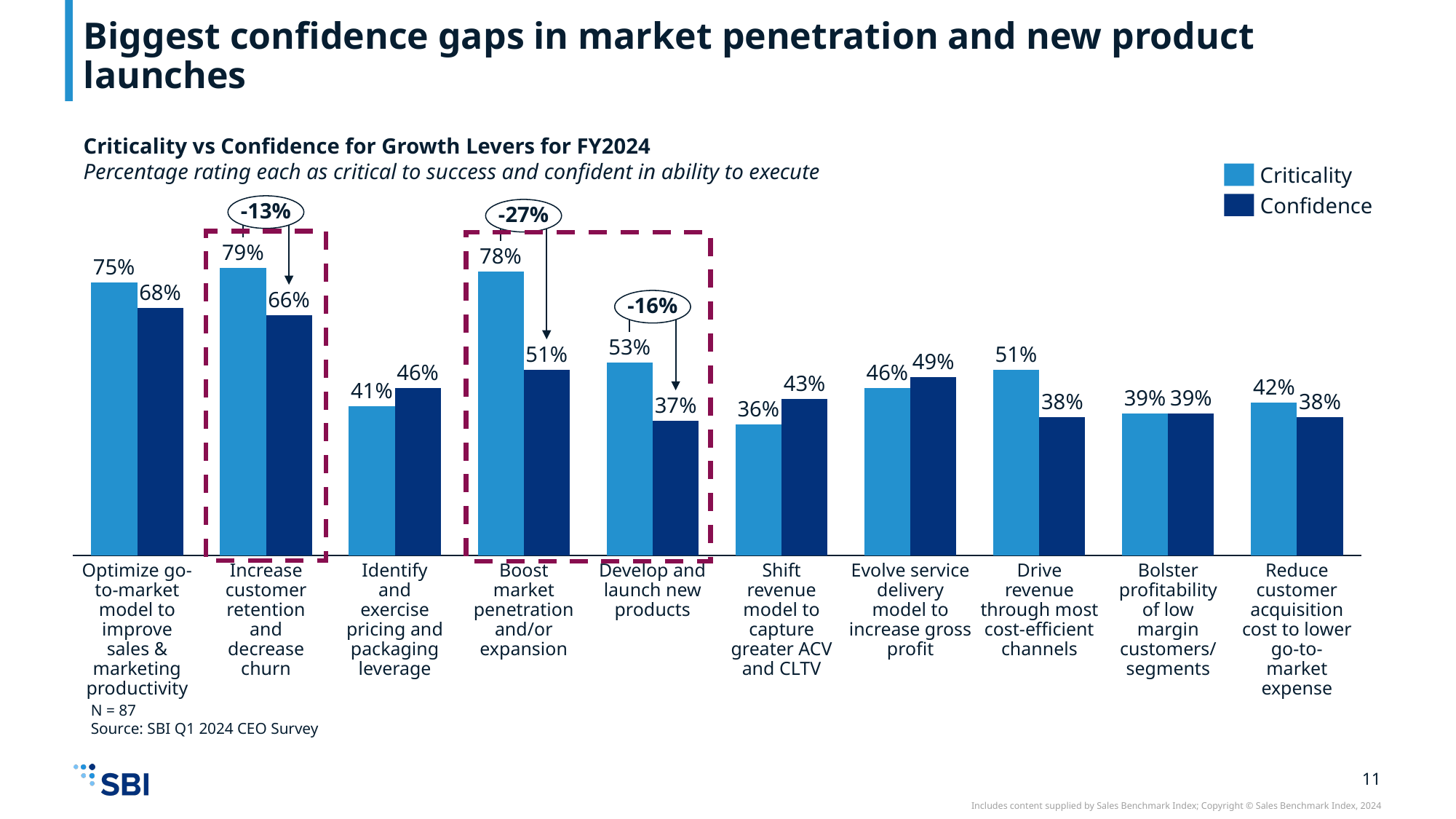
How many series does the legend list? 2 Which growth lever has the highest Criticality value? Increase customer retention and decrease churn What is the Confidence value for 'Optimize go-to-market model to improve sales & marketing productivity'? 68% Which is larger for 'Identify and exercise pricing and packaging leverage': Criticality or Confidence? Confidence Which growth lever has the lowest Criticality value? Shift revenue model to capture greater ACV and CLTV How many growth levers (categories) are shown on the chart? 10 What is the Criticality value for 'Boost market penetration and/or expansion'? 78% What is the difference between Criticality and Confidence for 'Drive revenue through most cost-efficient channels'? 13% What is the Confidence value for 'Develop and launch new products'? 37% What is the difference between Criticality and Confidence for 'Boost market penetration and/or expansion'? 27% What is the title of the chart? Criticality vs Confidence for Growth Levers for FY2024 What kind of chart is shown on the slide? Bar chart